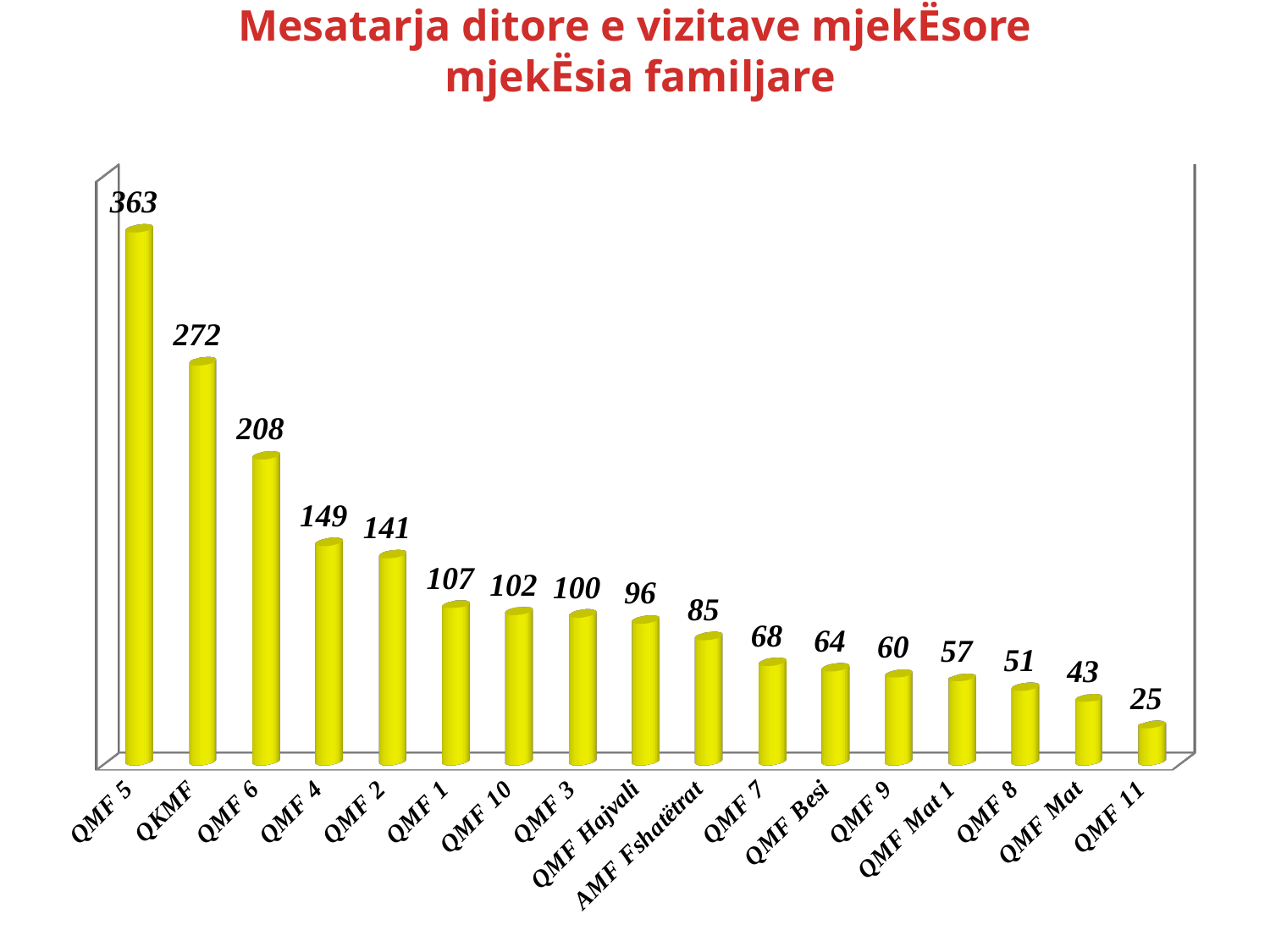
Which category has the lowest value? QMF 11 Which category has the highest value? QMF 5 What is the difference between the values for QMF 5 and QKMF? 91 What is the value for QMF Mat 1? 57 What is the difference between the values for QMF 6 and QMF 4? 59 What is the value for AMF Fshatërat? 85 What kind of chart is shown on the slide? Bar chart What is the value for QMF Hajvali? 96 What is the value for QMF 5? 363 Which is larger, the value for QMF 2 or the value for QMF 1? QMF 2 How many categories are shown in the chart? 17 What is the value for QKMF? 272